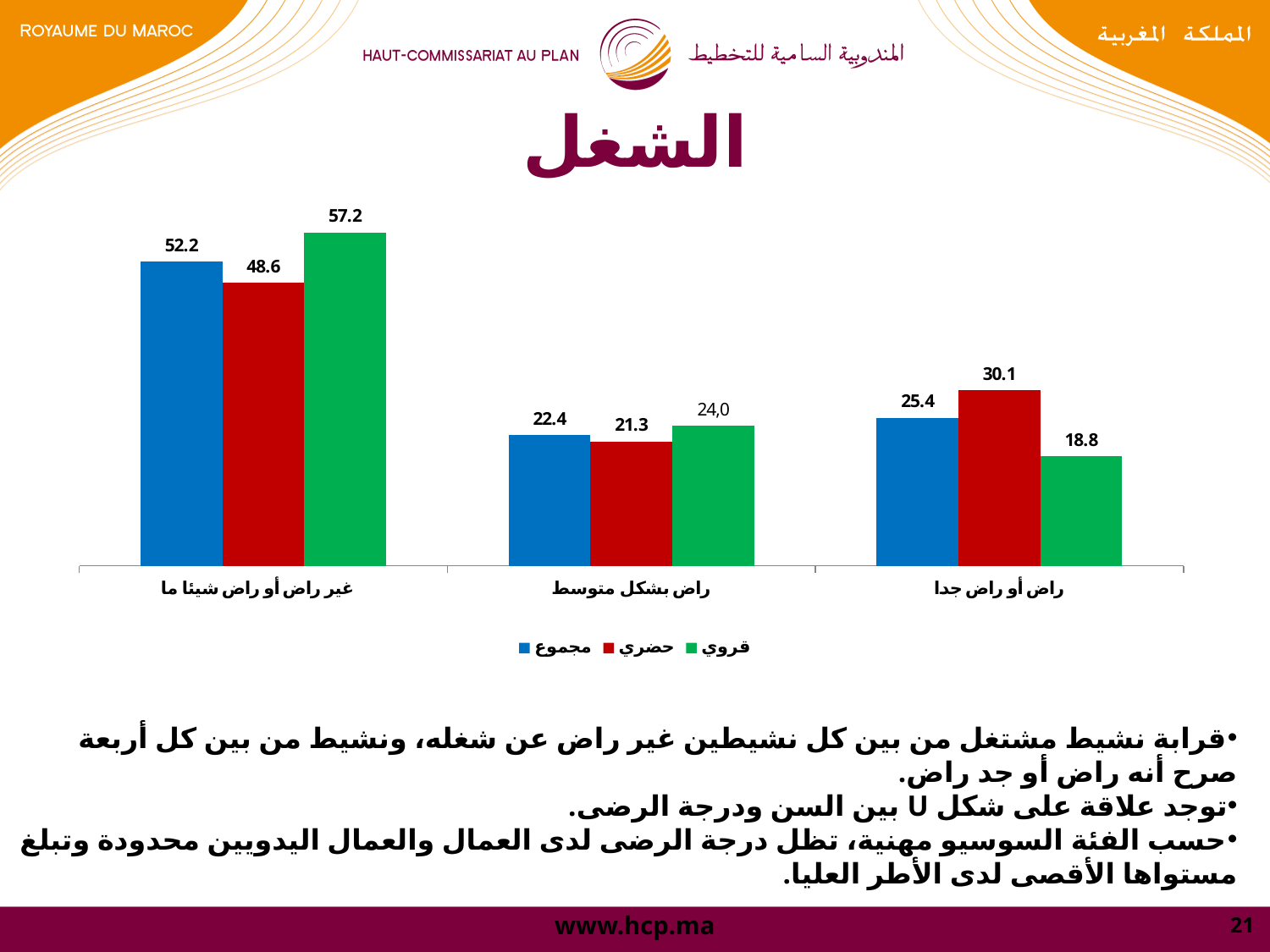
Which series has the highest value in the category غير راض أو راض شيئا ما? قروي What colour represents the series حضري in the chart? red How many series does the legend list? 3 What kind of chart is shown on the slide? bar chart Which series has the lowest value in the category راض أو راض جدا? قروي What is the difference between the قروي and حضري values in the category غير راض أو راض شيئا ما? 8.6 How many categories are shown on the x axis of the chart? 3 In the category راض أو راض جدا, which is larger: the value for حضري or the value for مجموع? حضري What is the value for قروي in the category راض بشكل متوسط? 24,0 What is the value for مجموع in the category غير راض أو راض شيئا ما? 52.2 What is the value for حضري in the category راض أو راض جدا? 30.1 What is the value for قروي in the category راض أو راض جدا? 18.8